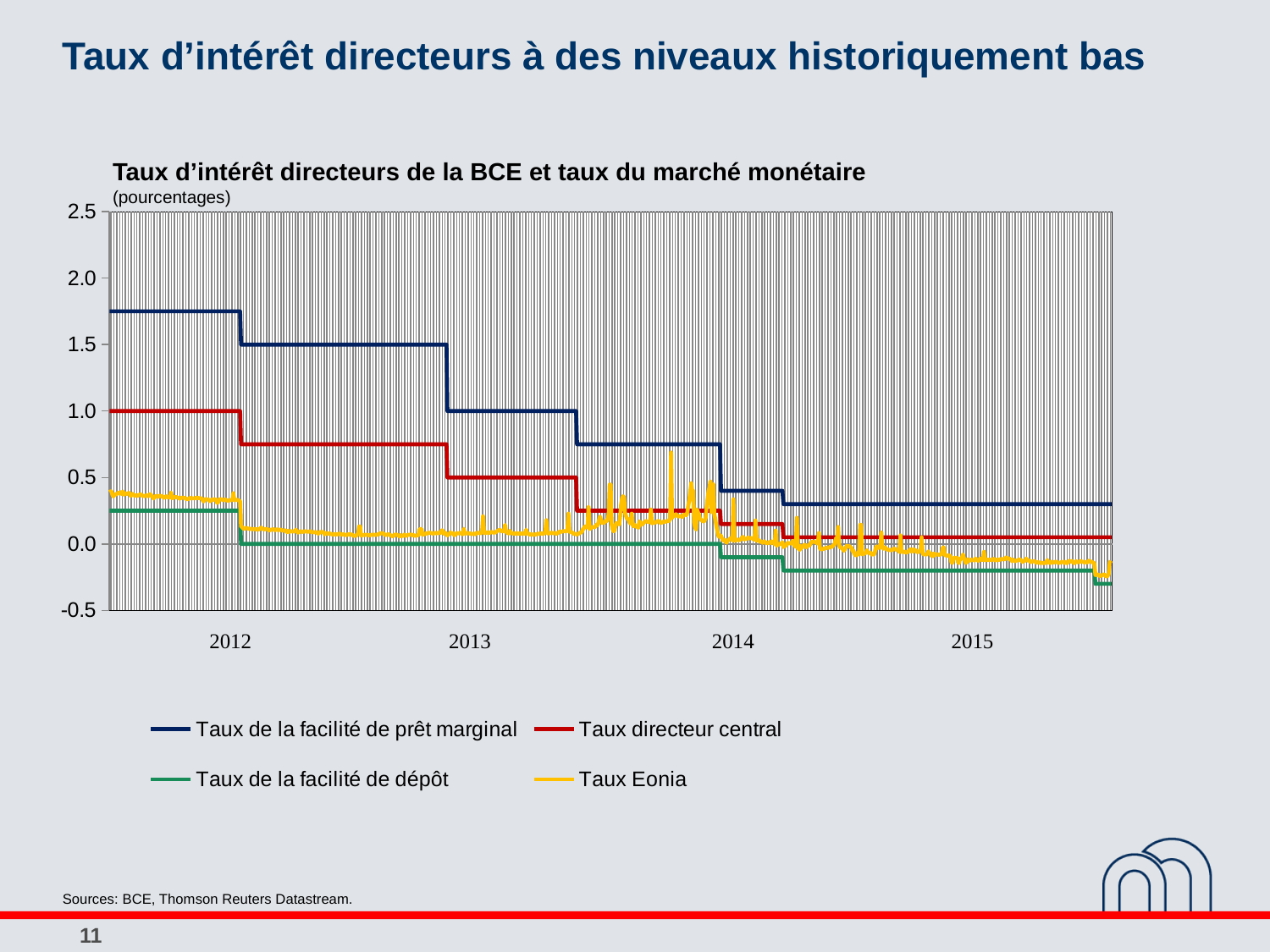
How many series does the legend list? 4 Does the Taux de la facilité de prêt marginal rise or fall over the period shown? Fall At the start of 2013, which is larger: the Taux directeur central or the Taux de la facilité de dépôt? Taux directeur central In what unit are the values on the chart expressed, according to the subtitle? pourcentages What kind of chart is shown on the slide? Line chart What is the title of the chart? Taux d'intérêt directeurs de la BCE et taux du marché monétaire Which series is the highest throughout the chart? Taux de la facilité de prêt marginal Is the value of the Taux de la facilité de dépôt in 2015 greater or less than 0.0? less Is the value of the Taux de la facilité de prêt marginal at the start of the chart greater or less than 1.5? greater